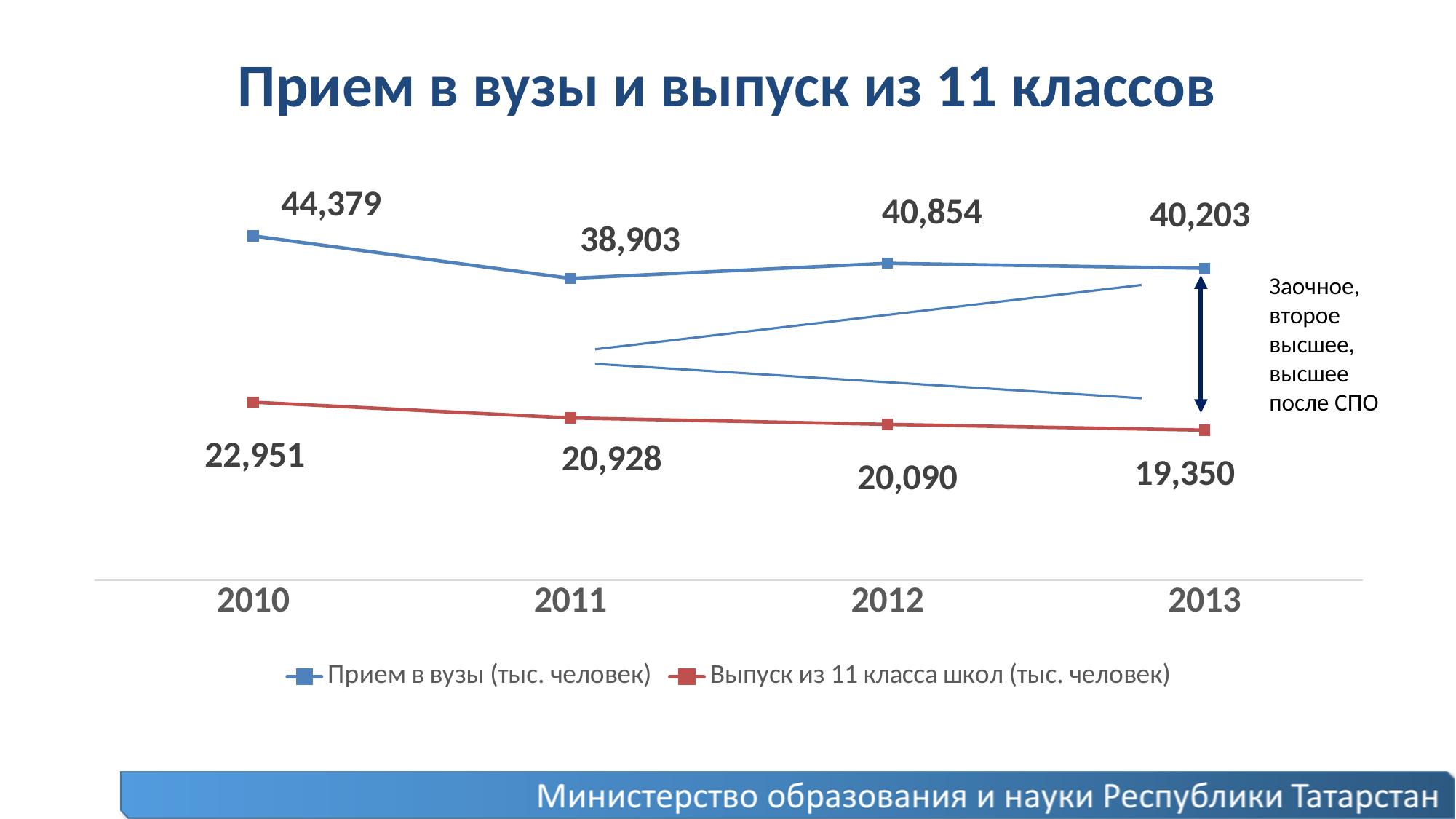
What is the value of the 'Выпуск из 11 класса школ (тыс. человек)' series in 2011? 20,928 How many years are shown on the x axis? 4 What is the value of the 'Прием в вузы (тыс. человек)' series in 2010? 44,379 What is the difference between 'Прием в вузы' and 'Выпуск из 11 класса школ' in 2010? 21,428 What is the value of the 'Прием в вузы (тыс. человек)' series in 2012? 40,854 Does the 'Выпуск из 11 класса школ (тыс. человек)' series rise or fall from 2010 to 2013? fall In which year is the 'Выпуск из 11 класса школ (тыс. человек)' series at its highest? 2010 How many series does the legend list? 2 Which is larger: 'Прием в вузы' in 2012 or 'Прием в вузы' in 2013? 2012 By how much did 'Прием в вузы (тыс. человек)' fall from 2010 to 2011? 5,476 What is the value of the 'Выпуск из 11 класса школ (тыс. человек)' series in 2013? 19,350 In which year is the 'Прием в вузы (тыс. человек)' series at its lowest? 2011